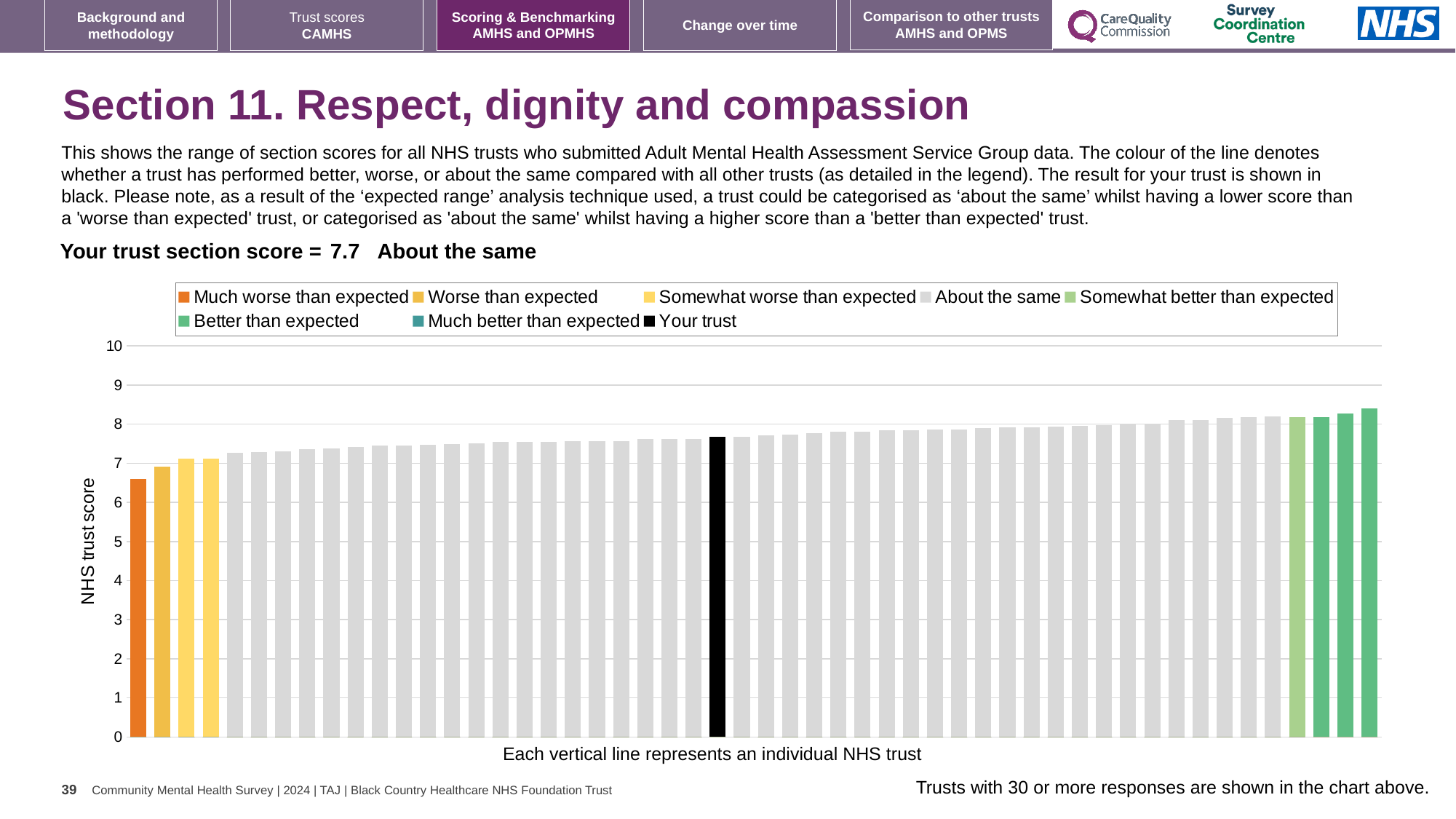
Is the value for the tallest bar in the chart greater or less than 9? less Is the value for the black 'Your trust' bar greater or less than 7? greater Do the bar values rise or fall from left to right across the chart? rise How many entries does the chart legend list? 8 Is the value for the orange 'Much worse than expected' bar greater or less than 7? less What is the label on the vertical axis of the chart? NHS trust score How many bars are coloured as 'Much worse than expected'? 1 What kind of chart is shown on the slide? bar chart Which category is your trust's section score placed in? About the same What is the section score for your trust shown on the slide? 7.7 Is the 'Much worse than expected' bar higher or lower than the 'Your trust' bar? lower